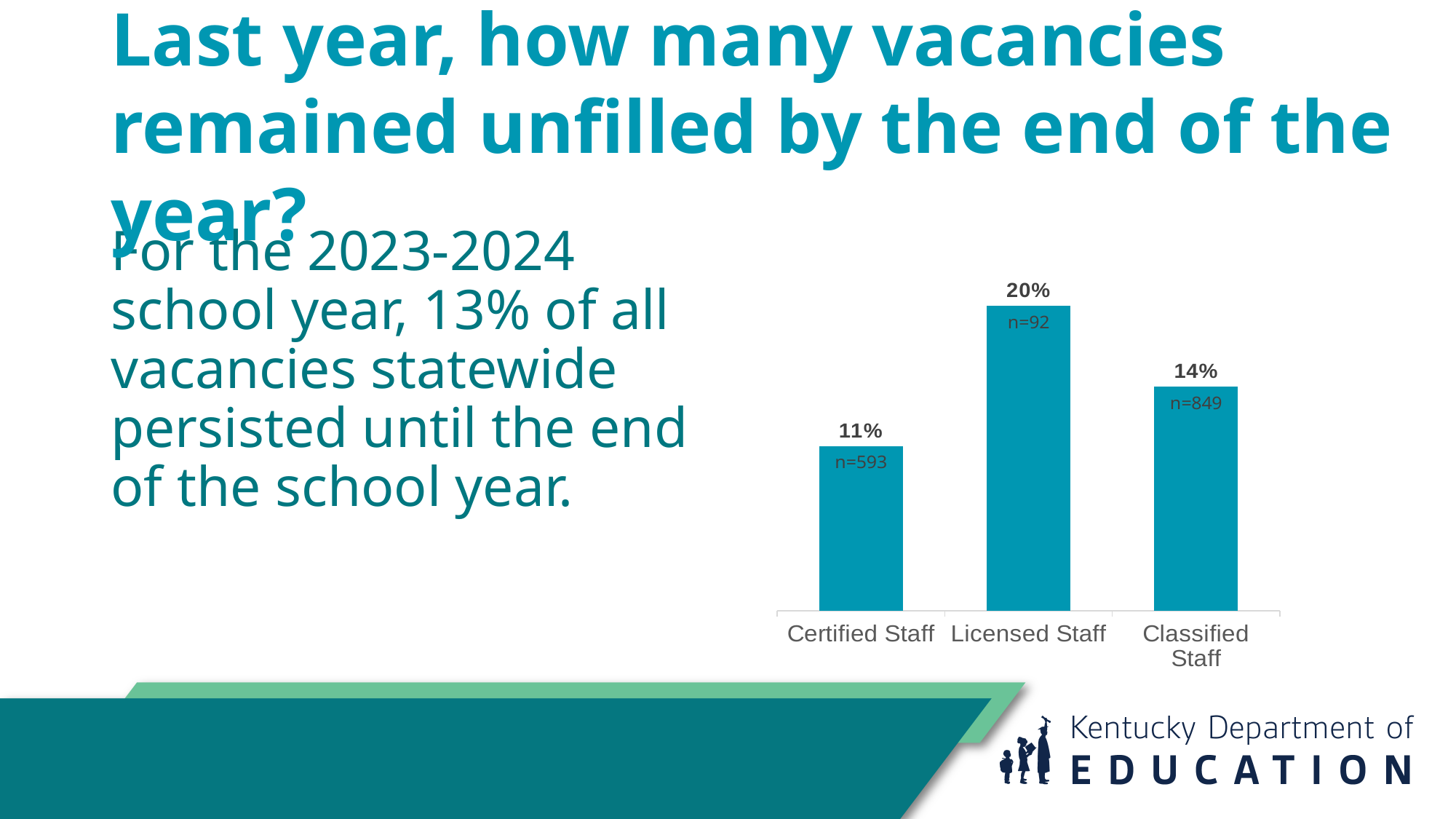
What percentage is shown for Licensed Staff? 20% What kind of chart is shown on the slide? Bar chart What is the n value printed on the Classified Staff bar? n=849 Which staff category has the lowest percentage? Certified Staff Which staff category has the highest percentage? Licensed Staff What is the n value printed on the Certified Staff bar? n=593 What is the difference in percentage points between Licensed Staff and Certified Staff? 9 What percentage is shown for Certified Staff? 11% How many staff categories are shown in the chart? 3 What percentage is shown for Classified Staff? 14% Which is larger, the percentage for Classified Staff or for Certified Staff? Classified Staff What is the n value printed on the Licensed Staff bar? n=92